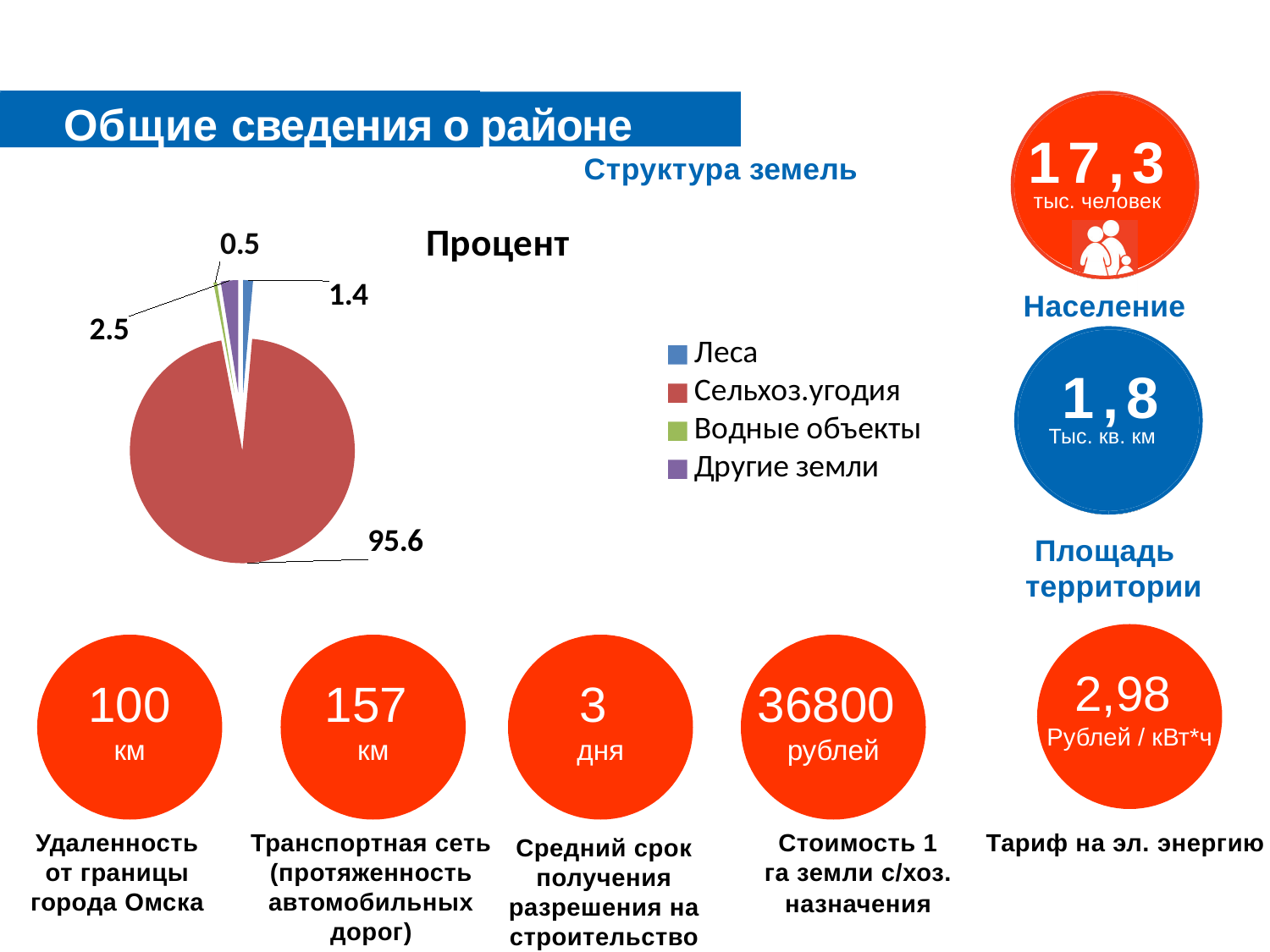
In the pie chart "Процент", which is larger: Водные объекты or Леса? Леса What is the value for Леса in the pie chart "Процент"? 1.4 What kind of chart is shown under the heading "Структура земель"? pie chart What colour is the Сельхоз.угодия slice in the pie chart "Процент"? red Which category has the smallest slice in the pie chart "Процент"? Водные объекты What is the value for Сельхоз.угодия in the pie chart "Процент"? 95.6 What is the value for Другие земли in the pie chart "Процент"? 2.5 What is the value for Водные объекты in the pie chart "Процент"? 0.5 How many slices does the pie chart "Процент" have? 4 Which category has the largest slice in the pie chart "Процент"? Сельхоз.угодия What is the title of the pie chart on the slide? Процент In the pie chart "Процент", what is the difference between the values for Сельхоз.угодия and Леса? 94.2